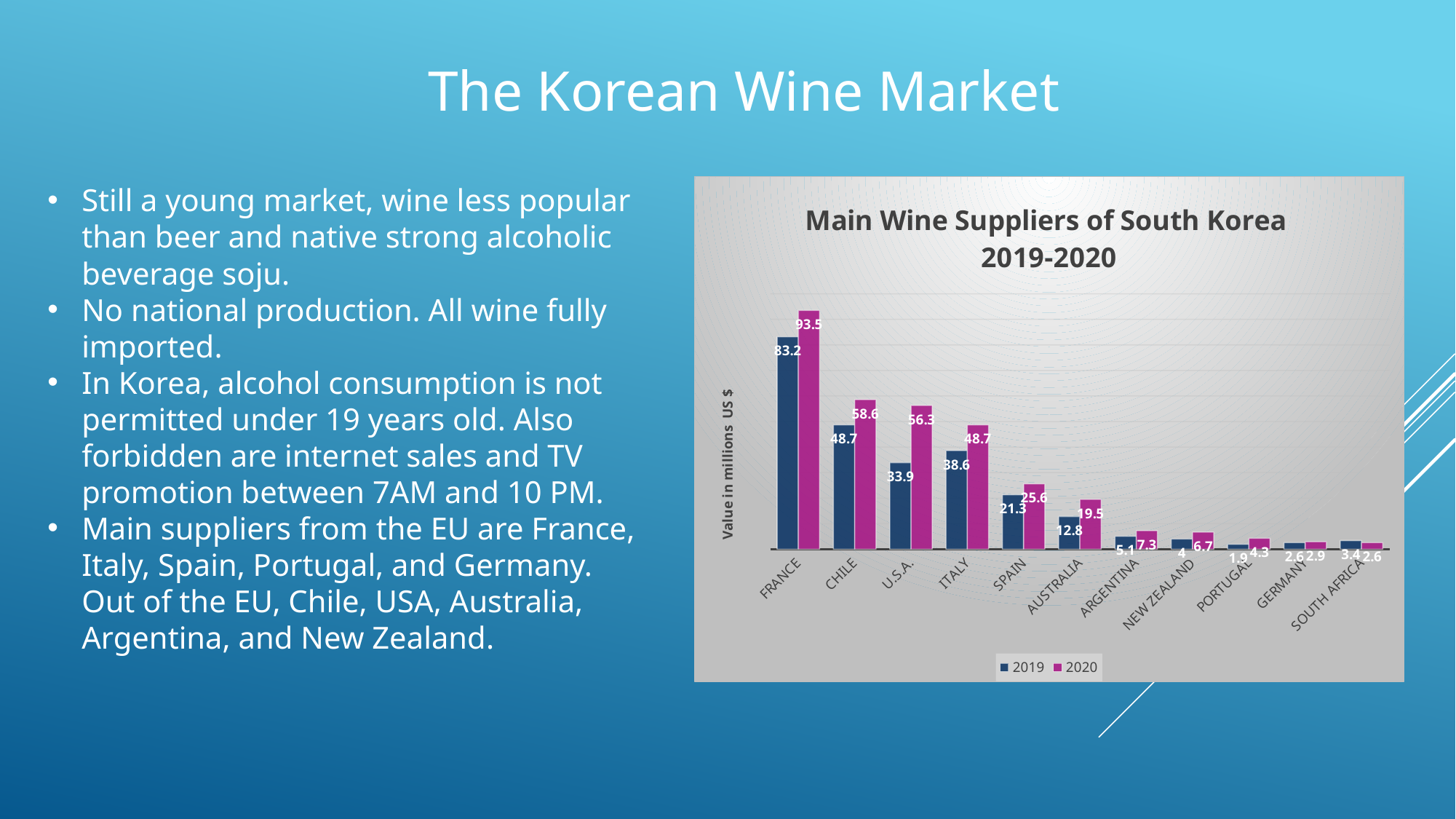
What kind of chart is shown on the slide? Bar chart How many countries are shown on the x axis? 11 Which country had the highest value in 2019? France What is the title of the chart? Main Wine Suppliers of South Korea 2019-2020 Which was larger in 2020: Italy or Spain? Italy Which country had the lowest value in 2019? Portugal What was the value for Australia in 2020? 19.5 How many series does the legend list? 2 What was the value for France in 2020? 93.5 What was the value for Italy in 2019? 38.6 Which was larger for Chile: the 2019 value or the 2020 value? 2020 What is the difference between the 2020 and 2019 values for the U.S.A.? 22.4